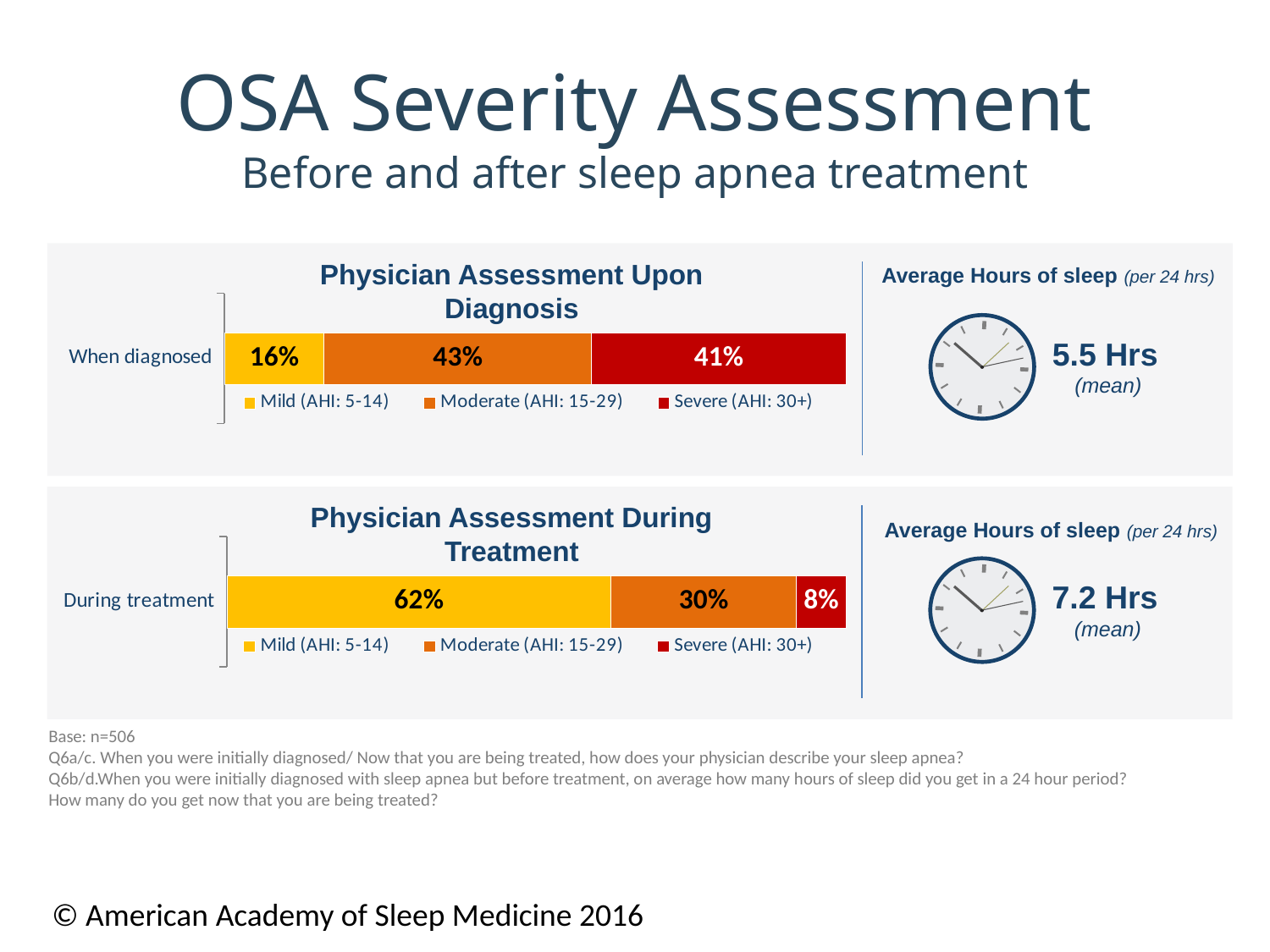
In the 'Physician Assessment During Treatment' chart, what percentage is shown for Severe (AHI: 30+)? 8% Is the Severe (AHI: 30+) percentage larger in the 'Physician Assessment Upon Diagnosis' chart or the 'Physician Assessment During Treatment' chart? Physician Assessment Upon Diagnosis What is the total of the stacked bar in the 'Physician Assessment Upon Diagnosis' chart? 100% What type of chart is the 'Physician Assessment Upon Diagnosis' chart? Stacked bar chart In the 'Physician Assessment Upon Diagnosis' chart, what percentage is shown for Severe (AHI: 30+)? 41% In the 'Physician Assessment During Treatment' chart, which severity category has the smallest share? Severe (AHI: 30+) In the 'Physician Assessment Upon Diagnosis' chart, what is the difference between the Moderate and Mild percentages? 27% In the 'Physician Assessment Upon Diagnosis' chart, what percentage is shown for Mild (AHI: 5-14)? 16% In the 'Physician Assessment During Treatment' chart, what percentage is shown for Moderate (AHI: 15-29)? 30% In the 'Physician Assessment During Treatment' chart, what is the difference between the Mild and Moderate percentages? 32% In the 'Physician Assessment Upon Diagnosis' chart, which severity category has the largest share? Moderate (AHI: 15-29) How many series does the legend of the 'Physician Assessment During Treatment' chart list? 3